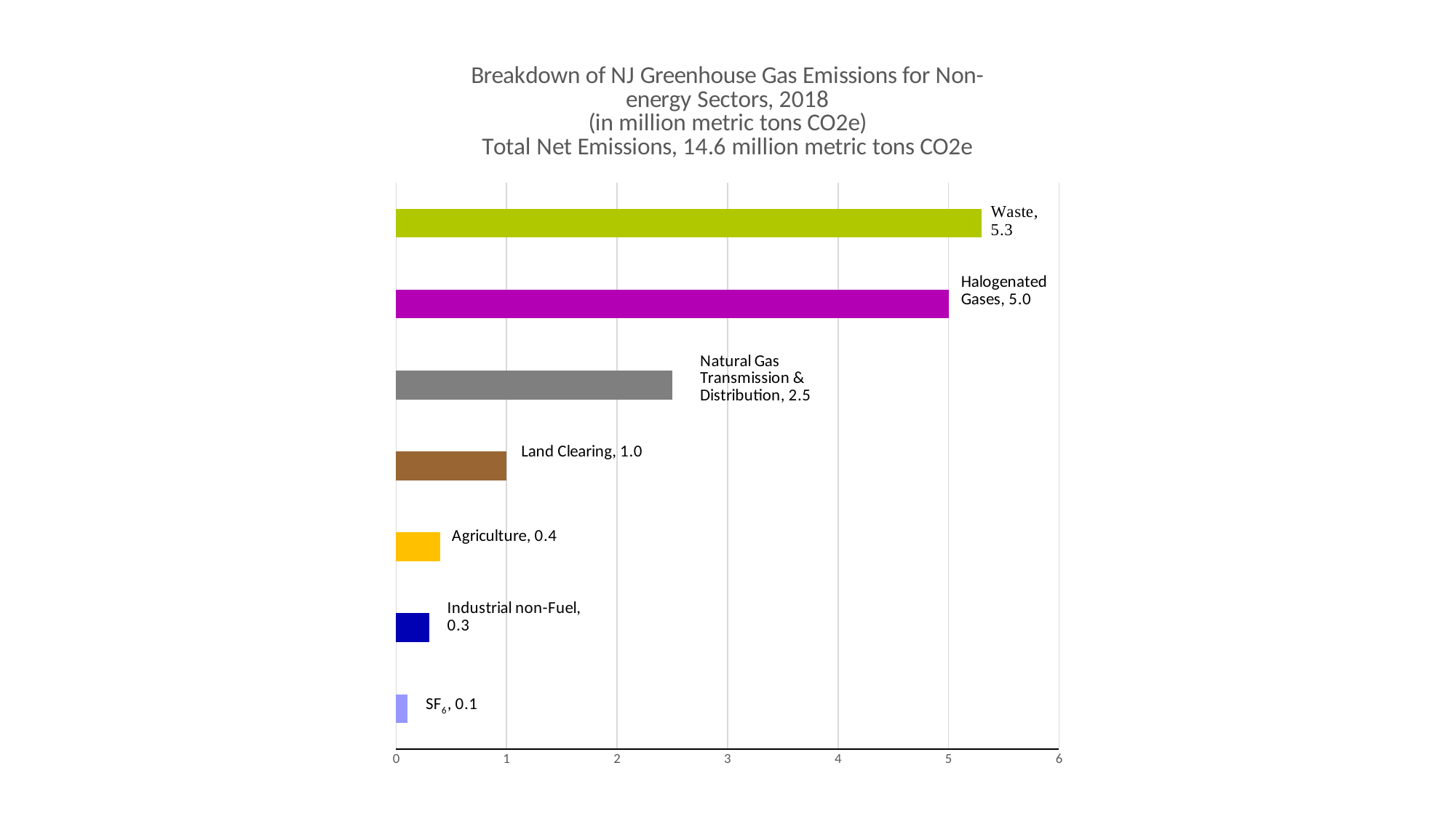
How many categories are shown in the chart? 7 What is the value for Halogenated Gases? 5.0 What is the value for Agriculture? 0.4 What is the difference between the values for Natural Gas Transmission & Distribution and Land Clearing? 1.5 Which category has the lowest value? SF6 Which category has the highest value? Waste What total net emissions figure is stated in the chart title? 14.6 million metric tons CO2e What is the value for Natural Gas Transmission & Distribution? 2.5 What is the value for Waste? 5.3 Which is larger, the value for Agriculture or the value for Industrial non-Fuel? Agriculture What kind of chart is shown on the slide? Bar chart What is the difference between the values for Waste and Halogenated Gases? 0.3